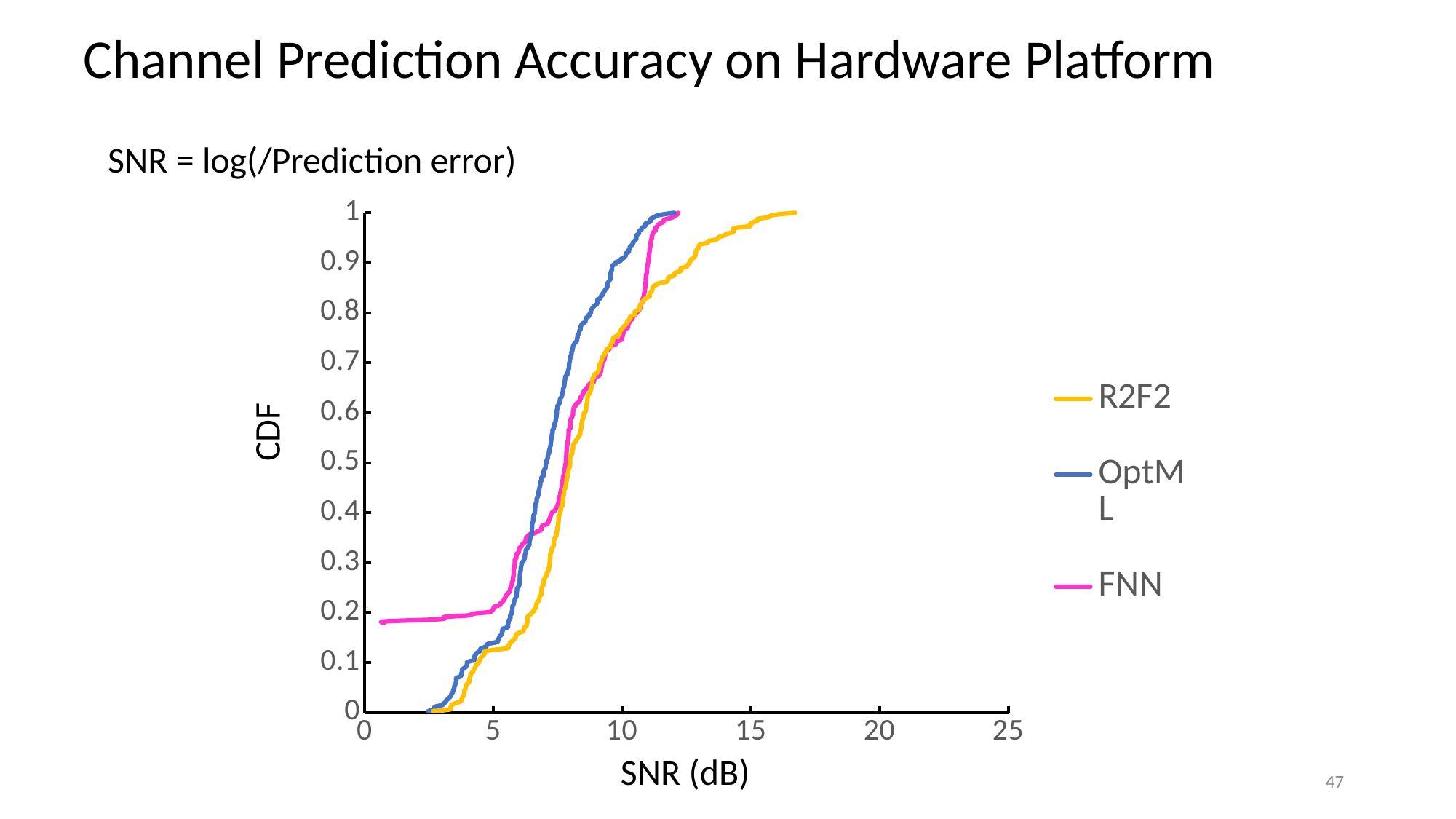
Which series has the highest CDF at an SNR of 2 dB? FNN What are the three series named in the legend? R2F2, OptML, FNN What kind of chart is shown on the slide? line chart Is the CDF of OptML at an SNR of 5 dB greater or less than 0.2? less At an SNR of 10 dB, which series has the higher CDF, OptML or R2F2? OptML Is the CDF of OptML at an SNR of 10 dB greater or less than 0.8? greater Do the CDF curves rise or fall as SNR increases along the x axis? rise Is the SNR at which OptML reaches a CDF of 1 greater or less than 15? less Which series reaches a CDF of 1 at the highest SNR? R2F2 What is the label of the x axis? SNR (dB) How many series does the legend list? 3